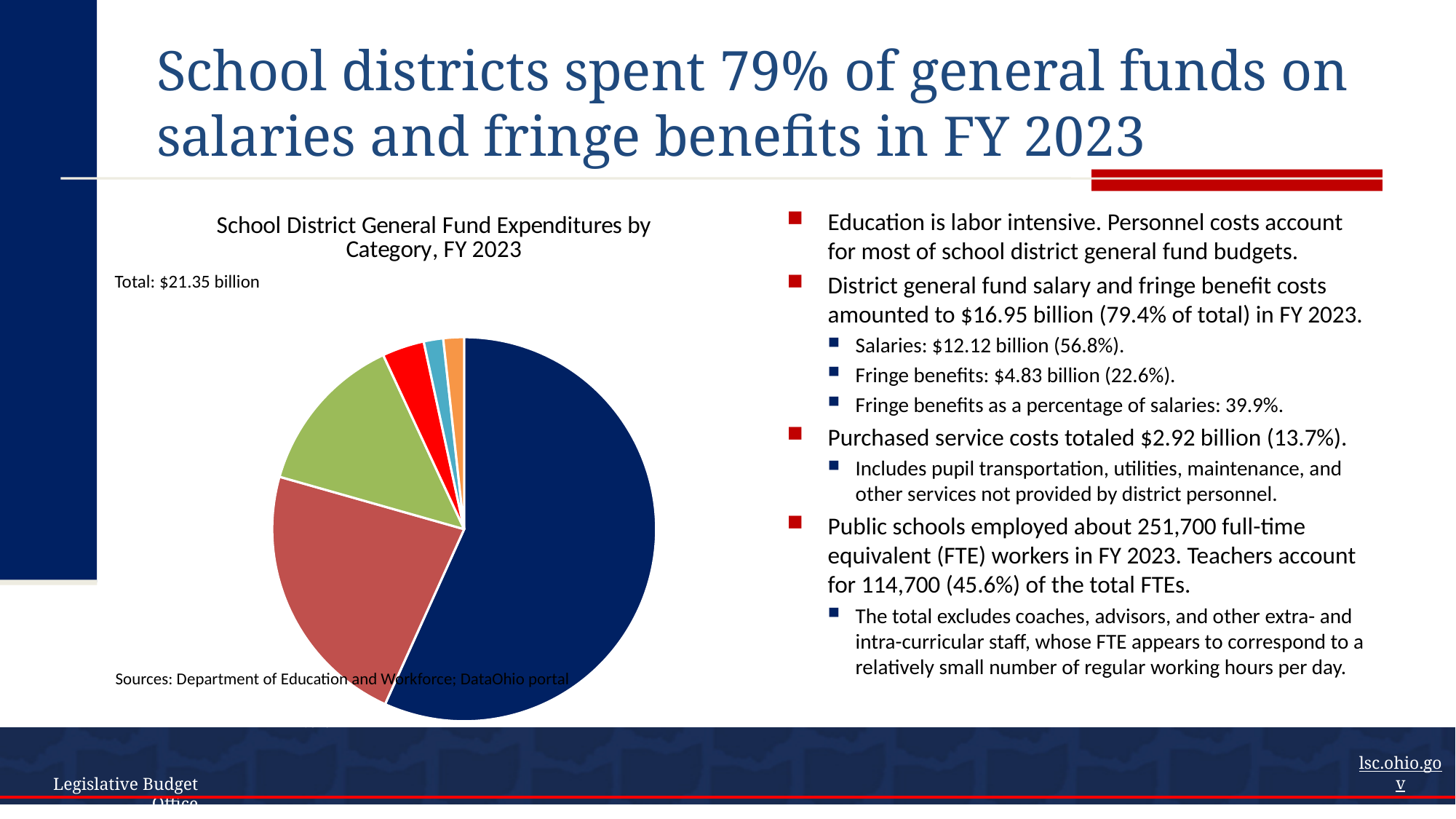
Which is larger in the pie chart, the dark blue slice or the red-brown slice? dark blue How many slices does the pie chart have? 6 Which colour slice is the largest in the pie chart? dark blue Which is larger in the pie chart, the green slice or the red slice? green What is the title of the chart on the slide? School District General Fund Expenditures by Category, FY 2023 Does the largest slice of the pie chart take up more or less than half of the pie? more Does the pie chart include a legend identifying the slices? No What total amount is printed above the pie chart? $21.35 billion What kind of chart is shown on the slide? pie chart